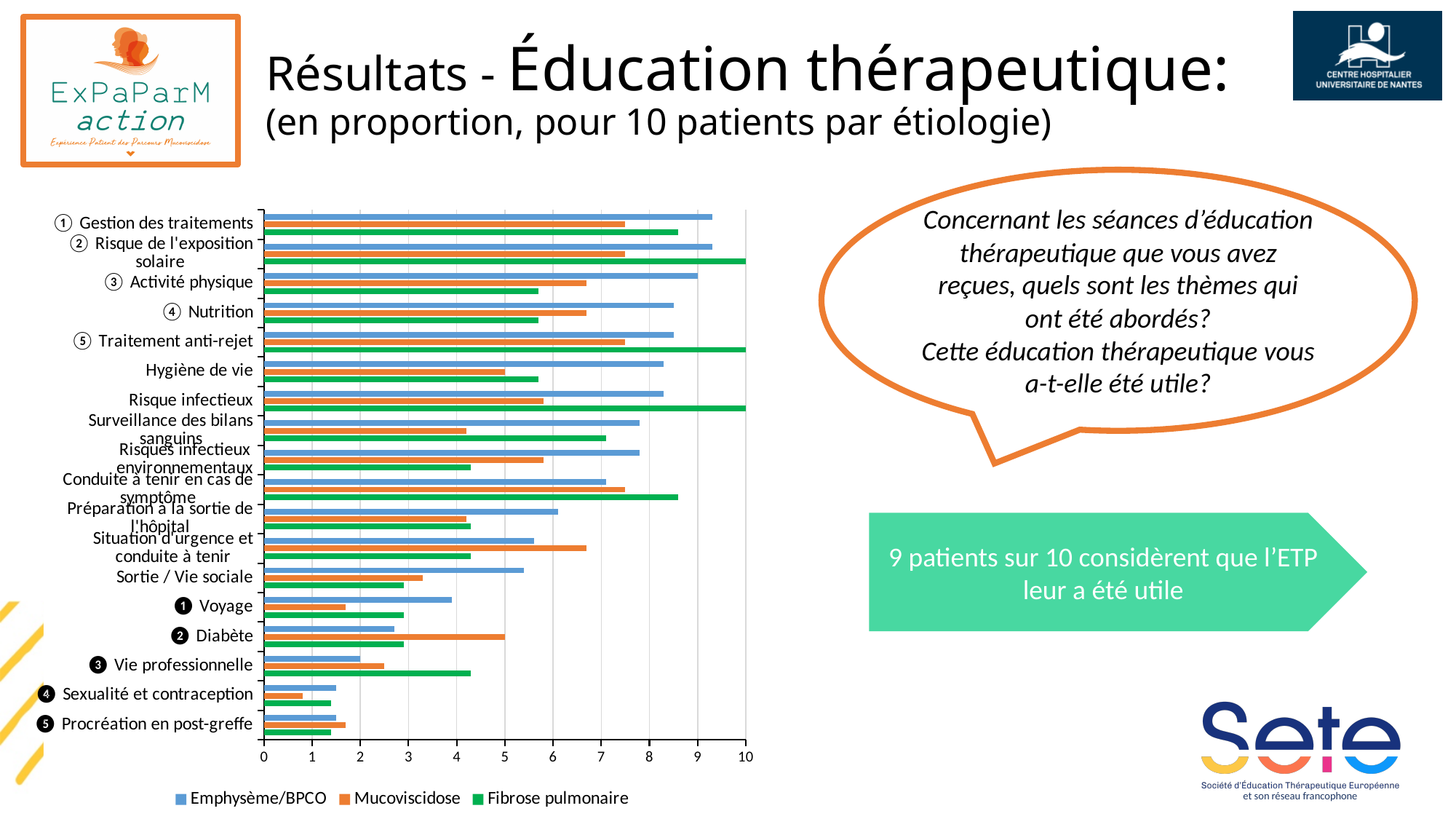
Is the value for Emphysème/BPCO for 'Gestion des traitements' greater or less than 9? greater Which category has the lowest value for the Mucoviscidose series? Sexualité et contraception For 'Hygiène de vie', which series has the larger value: Emphysème/BPCO or Fibrose pulmonaire? Emphysème/BPCO What is the value for Fibrose pulmonaire for 'Risque de l'exposition solaire'? 10 What is the value for Fibrose pulmonaire for 'Traitement anti-rejet'? 10 How many series does the chart legend list? 3 Is the value for Fibrose pulmonaire for 'Vie professionnelle' greater or less than 4? greater What kind of chart is shown on the slide? bar chart How many categories (themes) are plotted on the chart? 18 Is the value for Mucoviscidose for 'Voyage' greater or less than 2? less What is the value for Fibrose pulmonaire for 'Risque infectieux'? 10 For 'Diabète', which series has the larger value: Emphysème/BPCO or Mucoviscidose? Mucoviscidose